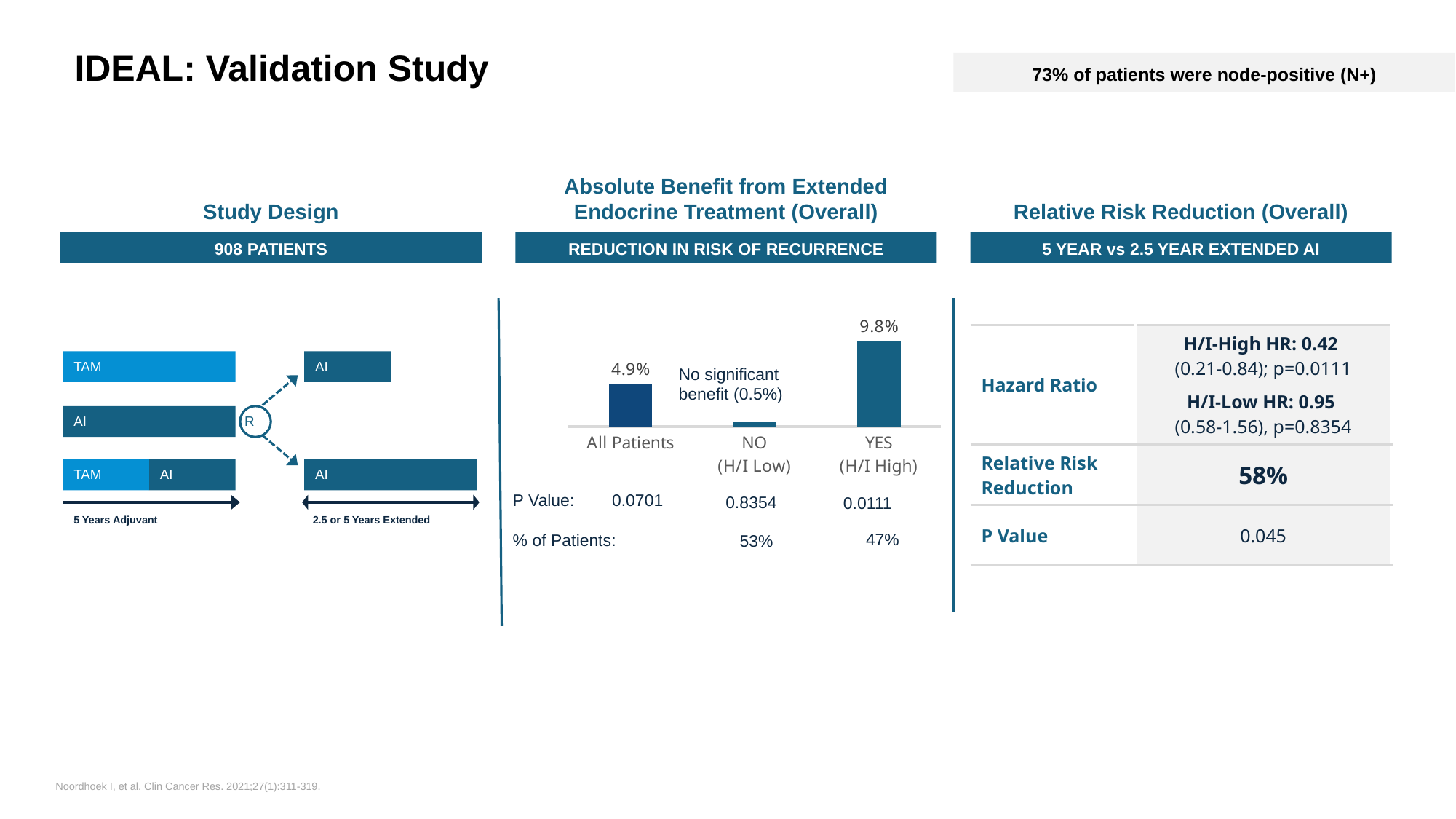
What kind of chart is shown under "Absolute Benefit from Extended Endocrine Treatment (Overall)"? bar chart In the Absolute Benefit chart, what P value is listed for YES (H/I High)? 0.0111 In the Absolute Benefit chart, what is the value for All Patients? 4.9% In the Absolute Benefit chart, what is the value for NO (H/I Low)? 0.5% In the Absolute Benefit chart, which category has the lowest value? NO (H/I Low) In the Absolute Benefit chart, what is the value for YES (H/I High)? 9.8% In the Absolute Benefit chart, which is larger: the value for All Patients or the value for NO (H/I Low)? All Patients In the Absolute Benefit chart, what is the difference between the YES (H/I High) and NO (H/I Low) values? 9.3% How many categories are shown in the Absolute Benefit chart? 3 In the Absolute Benefit chart, what is the difference between the YES (H/I High) and All Patients values? 4.9% In the Absolute Benefit chart, which category has the highest value? YES (H/I High) In the Absolute Benefit chart, what percentage of patients is listed for NO (H/I Low)? 53%